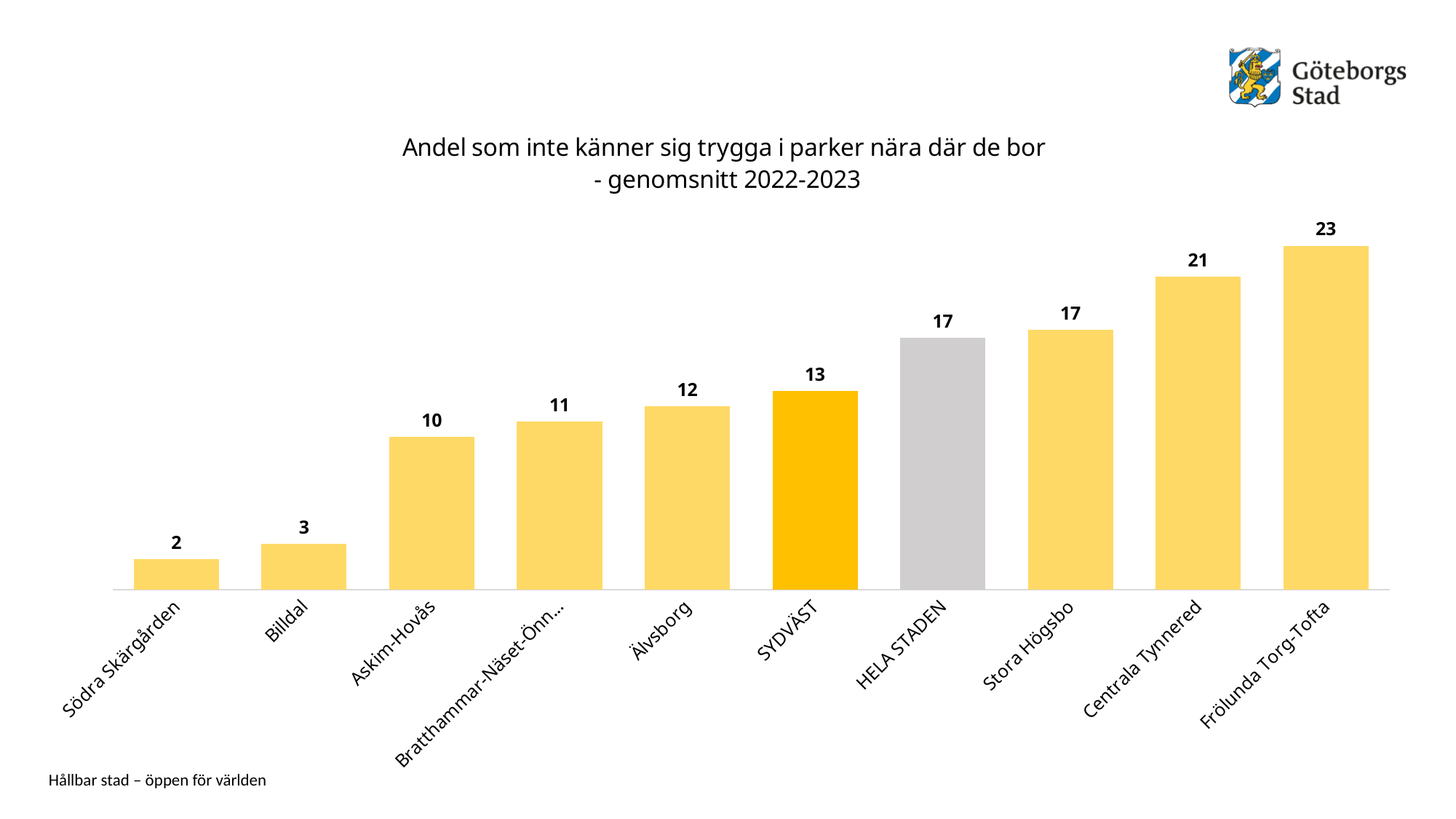
Which is larger, the value for Älvsborg or the value for Stora Högsbo? Stora Högsbo What is the value for SYDVÄST? 13 Which category has the highest value? Frölunda Torg-Tofta What kind of chart is shown on the slide? Bar chart Which category has the lowest value? Södra Skärgården How many categories are shown on the x axis? 10 What is the value for Billdal? 3 What is the value for HELA STADEN? 17 Do the values rise or fall from left to right along the x axis? Rise What is the value for Frölunda Torg-Tofta? 23 Which bar is coloured grey? HELA STADEN What is the difference between the values for Centrala Tynnered and Askim-Hovås? 11